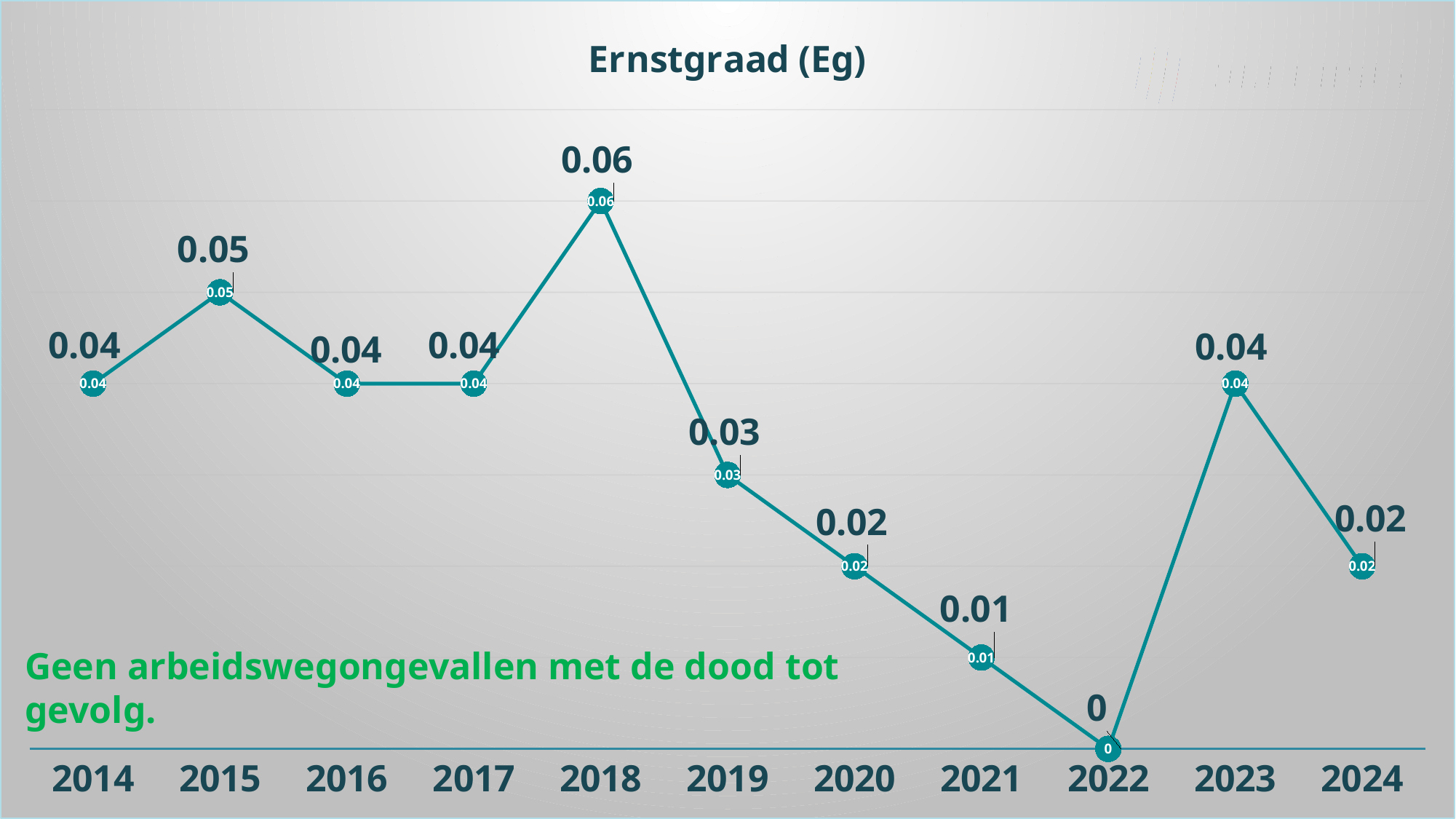
How many years are plotted on the Ernstgraad (Eg) chart? 11 Which year has a larger Ernstgraad (Eg) value, 2023 or 2024? 2023 What is the Ernstgraad (Eg) value for 2018? 0.06 What kind of chart is shown on the slide? line chart Do the Ernstgraad (Eg) values rise or fall from 2018 to 2022? fall What is the Ernstgraad (Eg) value for 2022? 0 What is the difference between the Ernstgraad (Eg) values for 2018 and 2019? 0.03 What is the Ernstgraad (Eg) value for 2015? 0.05 What is the title of the chart? Ernstgraad (Eg) Which year has the lowest Ernstgraad (Eg) value? 2022 Which year has the highest Ernstgraad (Eg) value? 2018 What is the Ernstgraad (Eg) value for 2024? 0.02